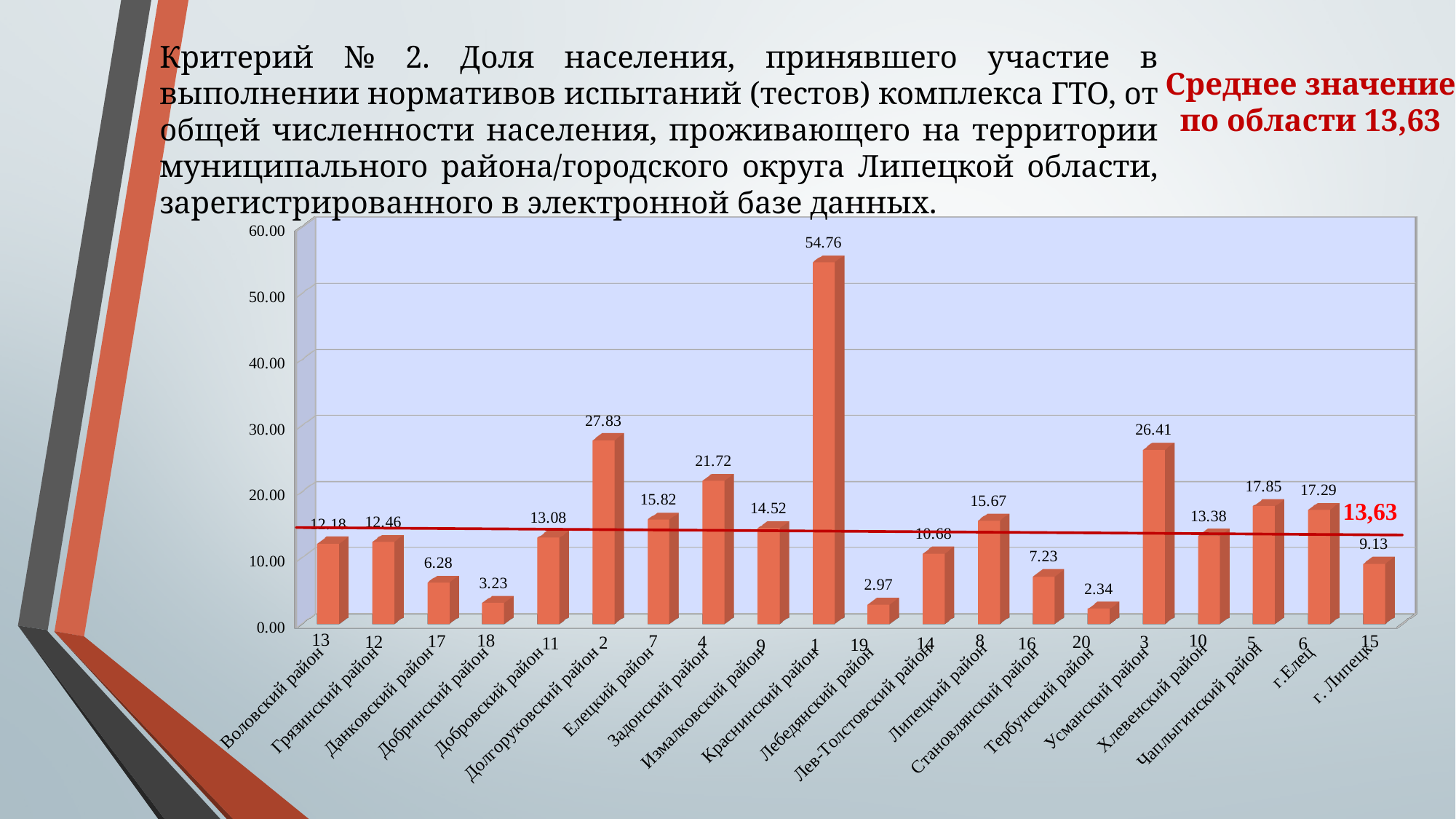
Which district has the lowest value? Тербунский район Which is larger, the value for Чаплыгинский район or г. Елец? Чаплыгинский район Which district has the highest value? Краснинский район What is the value for Краснинский район? 54.76 What is the value for Долгоруковский район? 27.83 Is the value for Данковский район greater or less than 10.00? less What value does the red horizontal line on the chart represent? 13,63 What is the difference between the values for Усманский район and Задонский район? 4.69 How many districts/cities are shown on the x axis? 20 What is the value for Лебедянский район? 2.97 What kind of chart is shown on the slide? bar chart What is the value for г. Липецк? 9.13